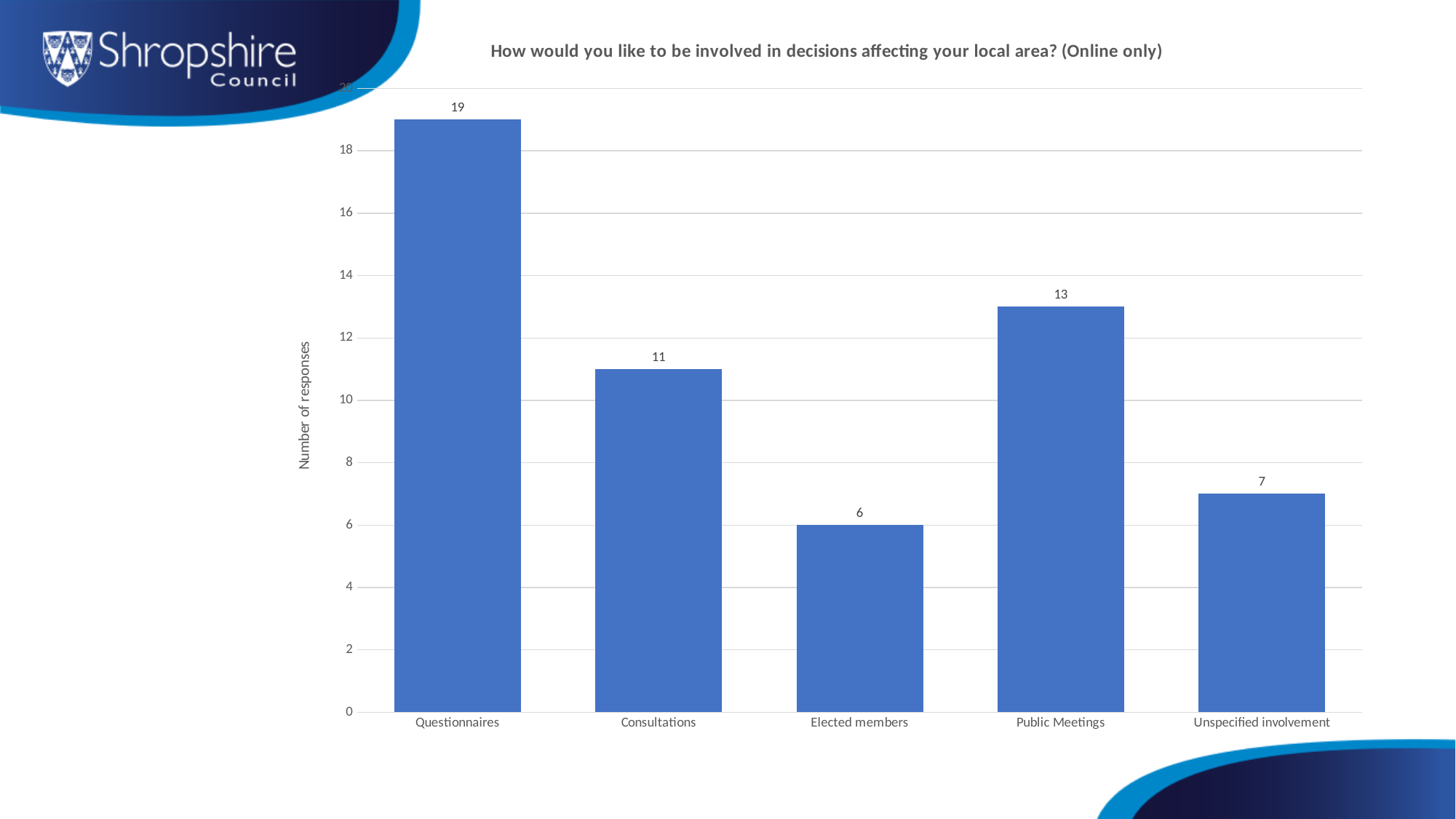
Which category has the highest number of responses? Questionnaires What is the number of responses for Elected members? 6 Which category has the lowest number of responses? Elected members Is the value for Unspecified involvement greater or less than 10? less Which has more responses, Consultations or Unspecified involvement? Consultations How many responses are shown for Questionnaires? 19 What kind of chart is shown on the slide? Bar chart What is the label of the vertical axis? Number of responses How many responses are shown for Public Meetings? 13 What is the number of responses for Consultations? 11 How many categories are shown on the x axis? 5 What is the difference in responses between Questionnaires and Public Meetings? 6